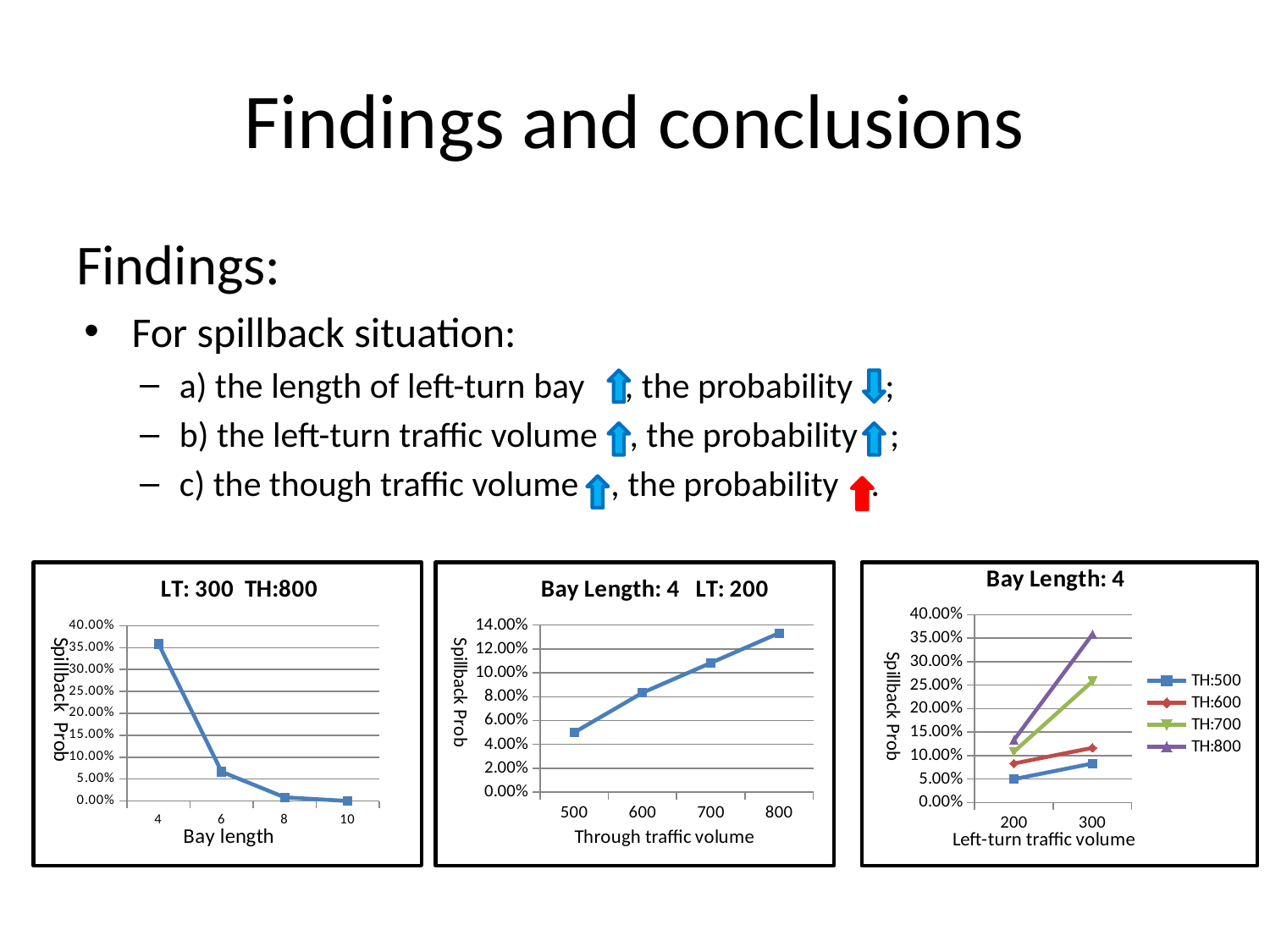
In the chart titled "Bay Length: 4" on the right, which series has the highest value at left-turn traffic volume 300? TH:800 In the chart titled "Bay Length: 4 LT: 200", is the value for through traffic volume 800 greater or less than 12.00%? greater How many series does the legend list in the chart titled "Bay Length: 4" on the right? 4 In the chart titled "LT: 300 TH:800", which bay length has the highest spillback probability? 4 In the chart titled "Bay Length: 4 LT: 200", do the values rise or fall as through traffic volume increases? rise In the chart titled "LT: 300 TH:800", is the value for bay length 6 greater or less than 10.00%? less In the chart titled "Bay Length: 4" on the right, is the TH:500 value at left-turn traffic volume 200 greater or less than 10.00%? less How many bay length values are plotted in the chart titled "LT: 300 TH:800"? 4 In the chart titled "LT: 300 TH:800", do the values rise or fall as bay length increases? fall In the chart titled "Bay Length: 4 LT: 200", which through traffic volume has the lowest spillback probability? 500 What kind of chart is the chart titled "LT: 300 TH:800"? line chart